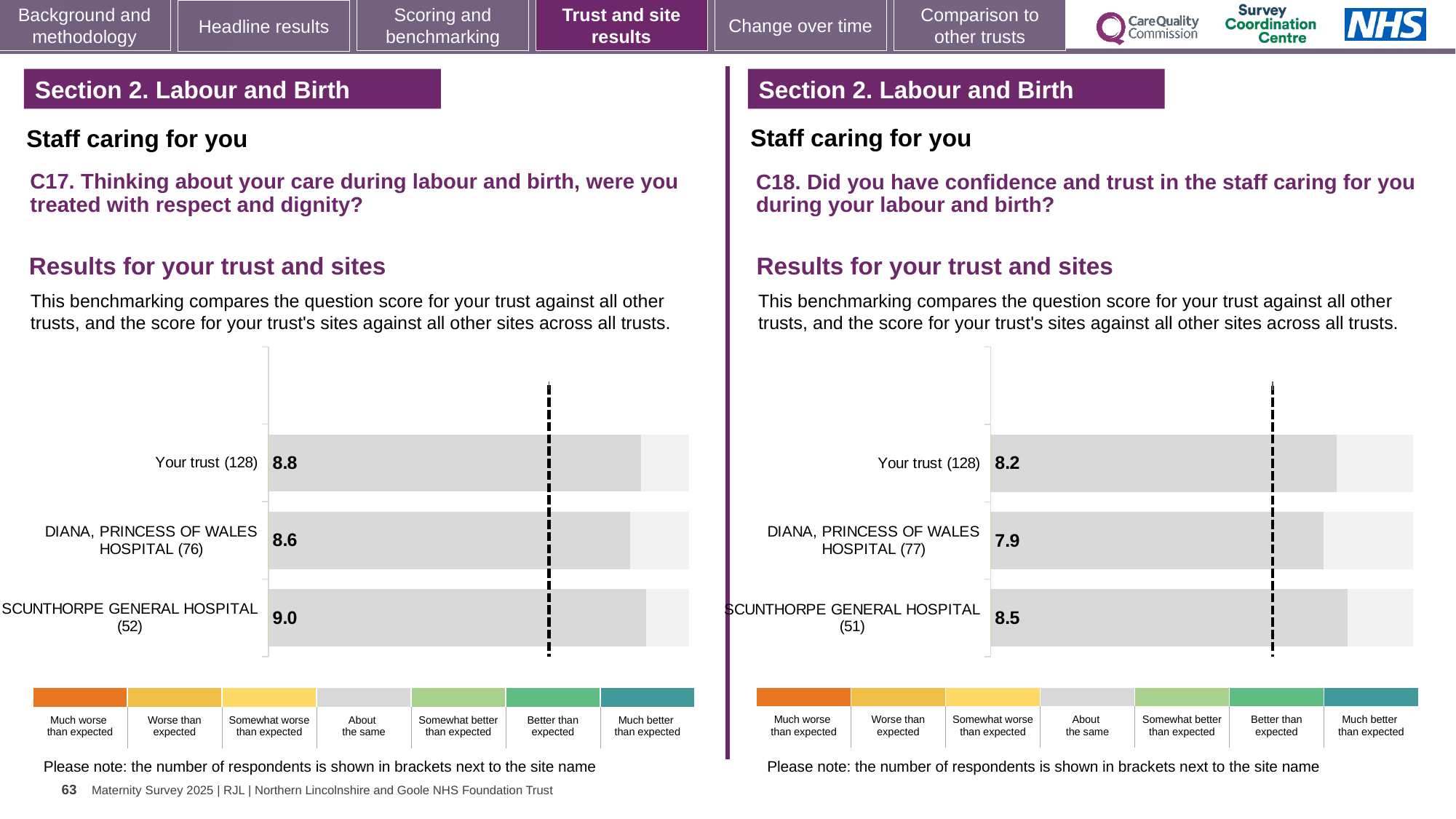
On the C18 chart (right), how many respondents are shown in brackets for Scunthorpe General Hospital? 51 On the C17 chart (left), what is the score for Your trust? 8.8 On the C18 chart (right), what is the score for Diana, Princess of Wales Hospital? 7.9 On the C17 chart (left), what is the score for Scunthorpe General Hospital? 9.0 What type of chart is used on the C18 chart (right)? Bar chart On the C18 chart (right), what is the score for Your trust? 8.2 How many bars are plotted on the C17 chart (left)? 3 On the C18 chart (right), which site or trust has the lowest score? Diana, Princess of Wales Hospital On the C17 chart (left), what is the difference between the scores for Scunthorpe General Hospital and Diana, Princess of Wales Hospital? 0.4 On the C17 chart (left), which site or trust has the highest score? Scunthorpe General Hospital On the C18 chart (right), what is the difference between the scores for Your trust and Scunthorpe General Hospital? 0.3 On the C18 chart (right), which has the higher score: Your trust or Scunthorpe General Hospital? Scunthorpe General Hospital